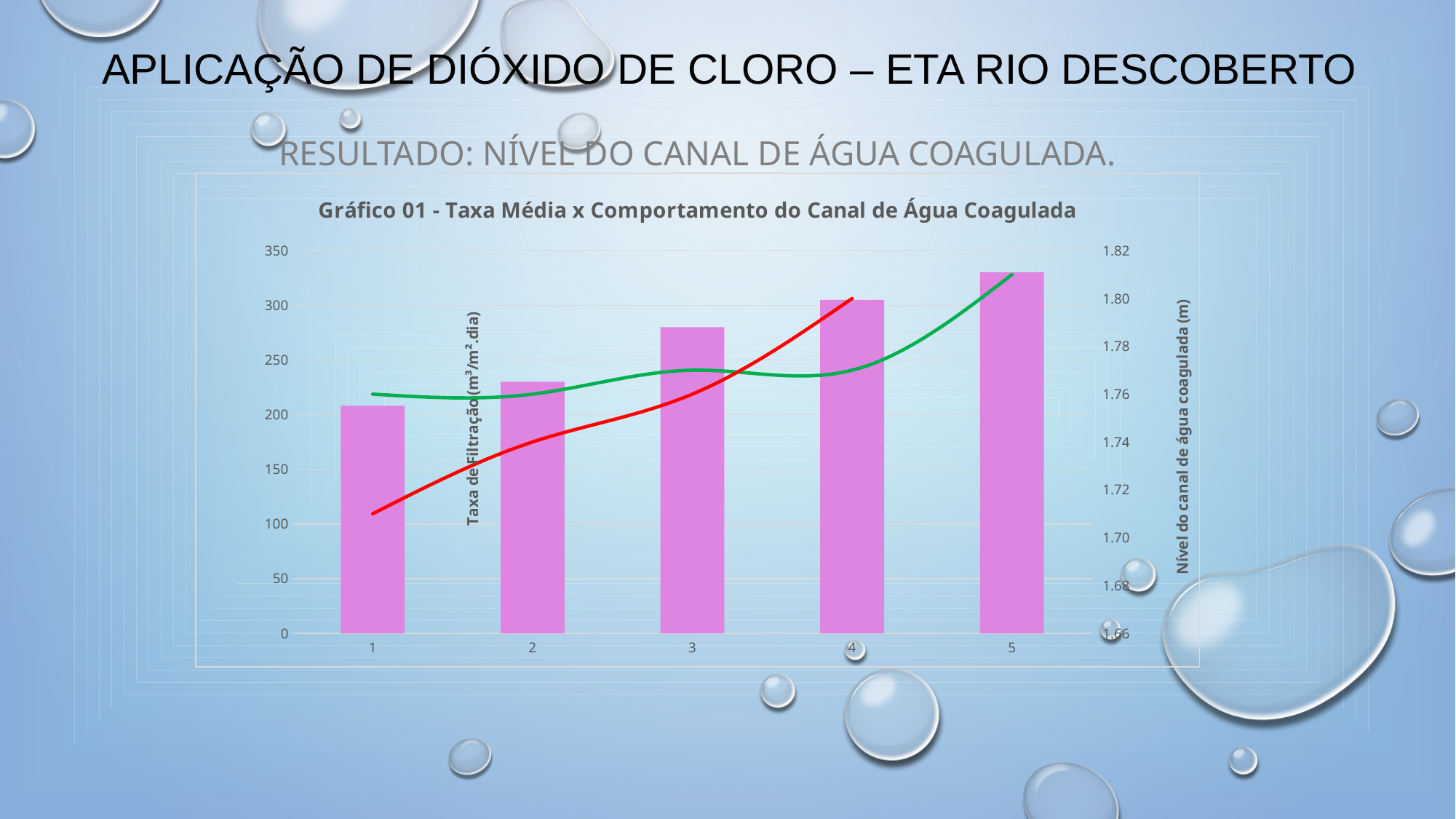
Is the bar value for category 3 greater or less than 250? greater Is the bar value for category 1 greater or less than 150? greater Which category has the tallest bar? 5 Do the bar values rise or fall from category 1 to category 5? Rise How many categories are shown on the x axis of the chart? 5 Is the bar value for category 5 greater or less than 300? greater What kind of chart is shown on the slide? A combined bar and line chart What is the title of the chart? Gráfico 01 - Taxa Média x Comportamento do Canal de Água Coagulada Which bar is taller, category 2 or category 3? Category 3 What is the title of the right-hand vertical axis? Nível do canal de água coagulada (m) Which category has the shortest bar? 1